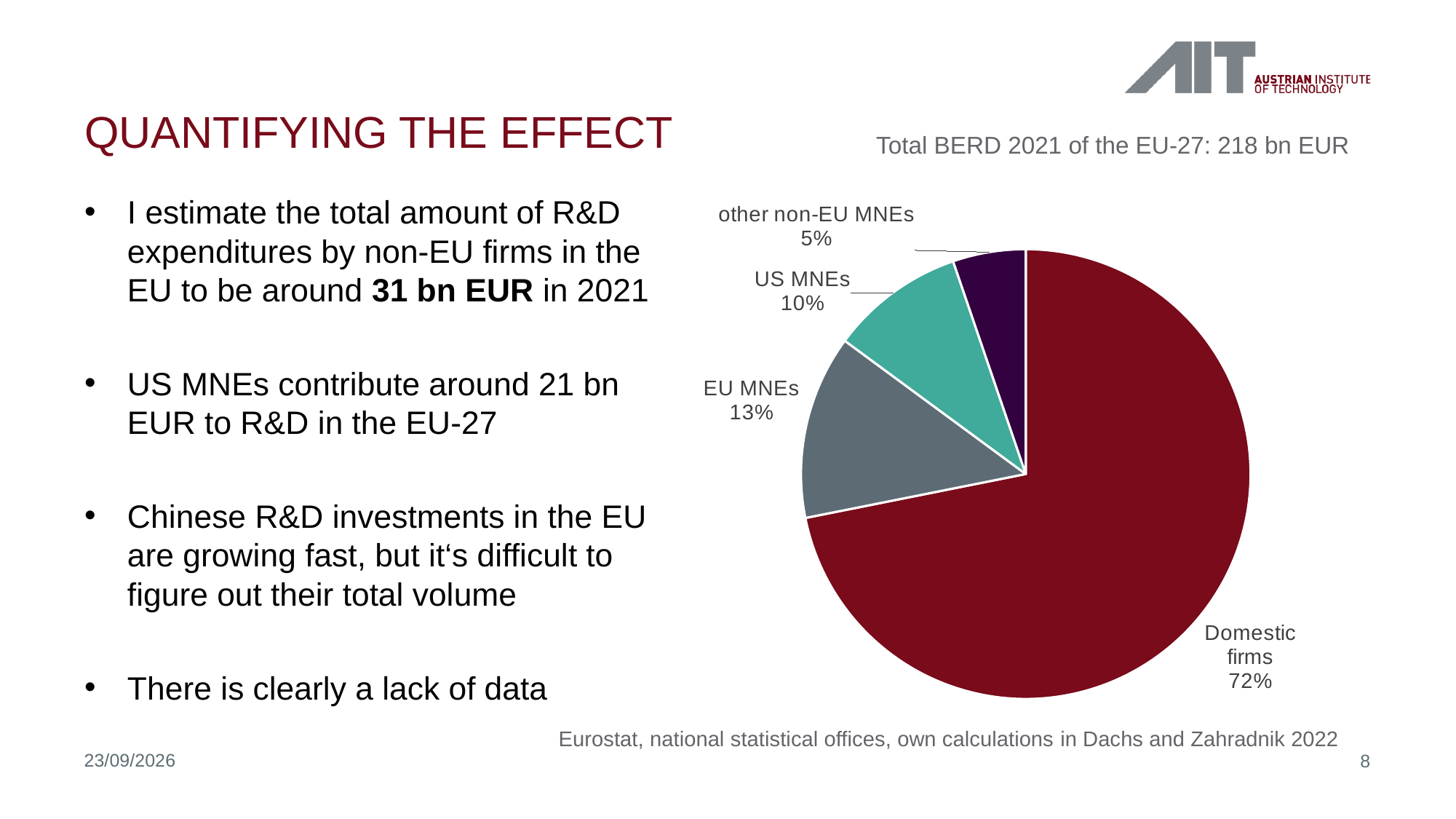
Which slice is larger, US MNEs or other non-EU MNEs? US MNEs Which category has the smallest slice of the pie? other non-EU MNEs What share of the pie do US MNEs account for? 10% What is the title shown above the pie chart? Total BERD 2021 of the EU-27: 218 bn EUR What share of the pie do other non-EU MNEs account for? 5% What kind of chart is shown on the slide? pie chart What share of the pie do EU MNEs account for? 13% How many slices does the pie chart have? 4 What is the difference in percentage points between the EU MNEs slice and the US MNEs slice? 3 percentage points Which category has the largest slice of the pie? Domestic firms What colour is the Domestic firms slice? dark red